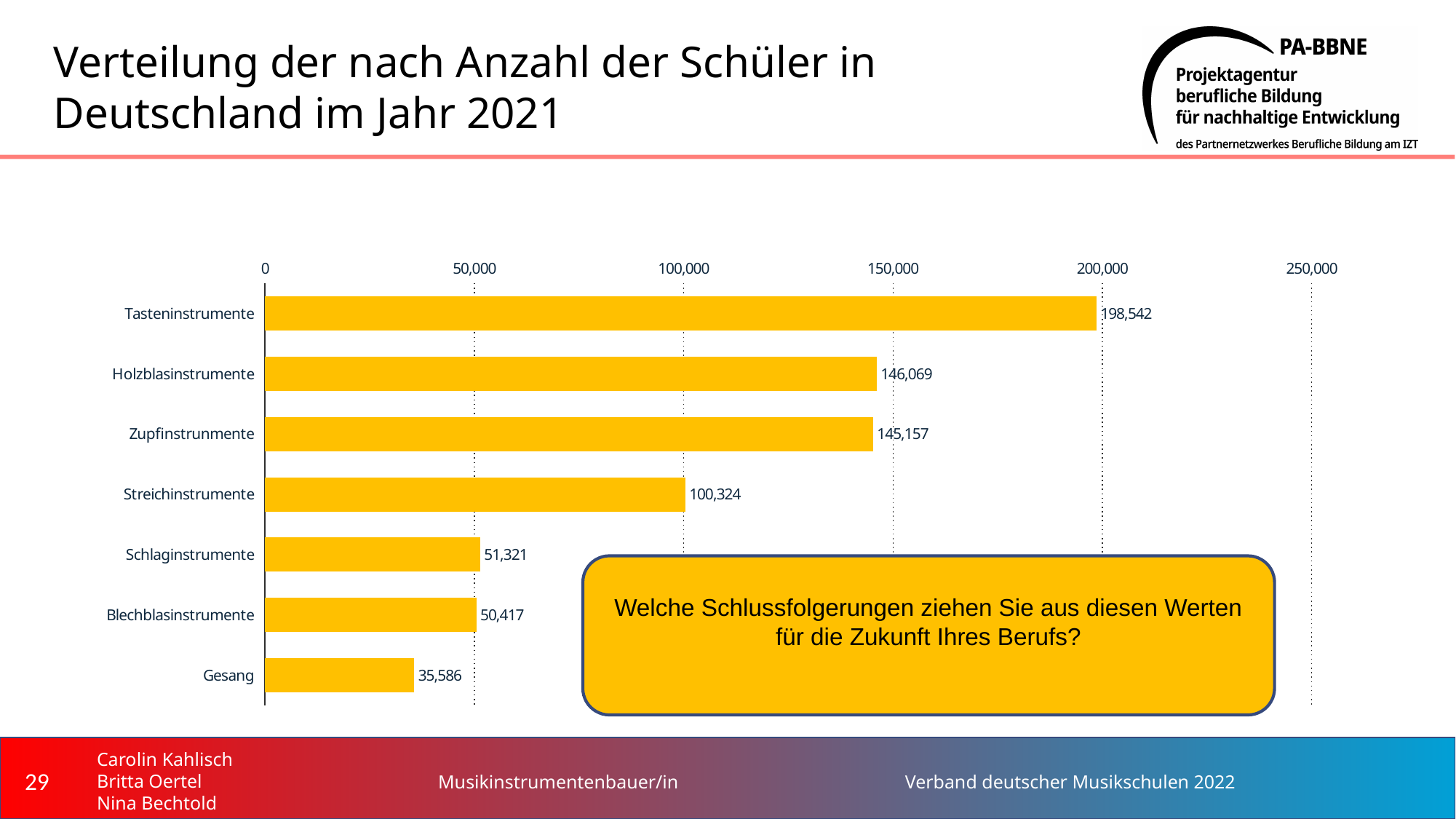
Is the value for Zupfinstrunmente greater or less than 150,000? less How many categories are shown in the chart? 7 Which is larger, the value for Streichinstrumente or the value for Schlaginstrumente? Streichinstrumente What colour are the bars in the chart? yellow What is the difference between the values for Tasteninstrumente and Holzblasinstrumente? 52,473 Which category has the highest value? Tasteninstrumente What kind of chart is shown on the slide? bar chart What is the value for Gesang? 35,586 What is the difference between the values for Schlaginstrumente and Blechblasinstrumente? 904 Which category has the lowest value? Gesang What is the value for Tasteninstrumente? 198,542 What is the value for Streichinstrumente? 100,324